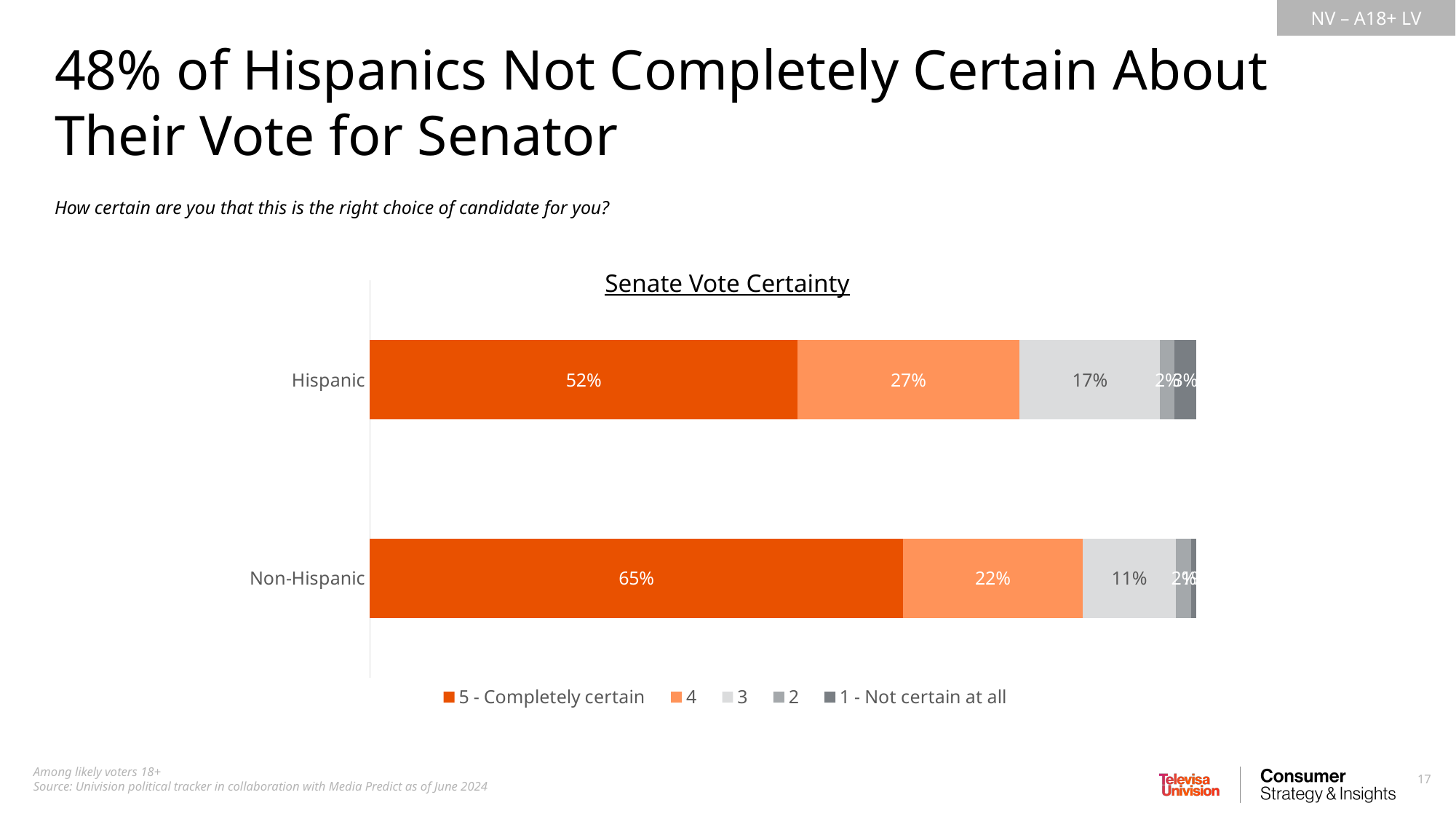
How many series does the legend list? 5 What percentage of Non-Hispanic likely voters are '5 - Completely certain' about their Senate vote? 65% What is the value for the '3' rating among Non-Hispanic voters? 11% What is the difference in percentage points between the Non-Hispanic and Hispanic '5 - Completely certain' values? 13 percentage points What percentage of Hispanic likely voters are '5 - Completely certain' about their Senate vote? 52% What is the difference in percentage points between the Hispanic and Non-Hispanic '4' values? 5 percentage points What is the value for the '4' rating among Non-Hispanic voters? 22% What type of chart is shown on the slide? Stacked bar chart Which group has the larger share of '5 - Completely certain' responses, Hispanic or Non-Hispanic? Non-Hispanic What is the value for the '4' rating among Hispanic voters? 27% Which group has the smaller share of '3' responses? Non-Hispanic How many groups (categories) are shown in the chart? 2